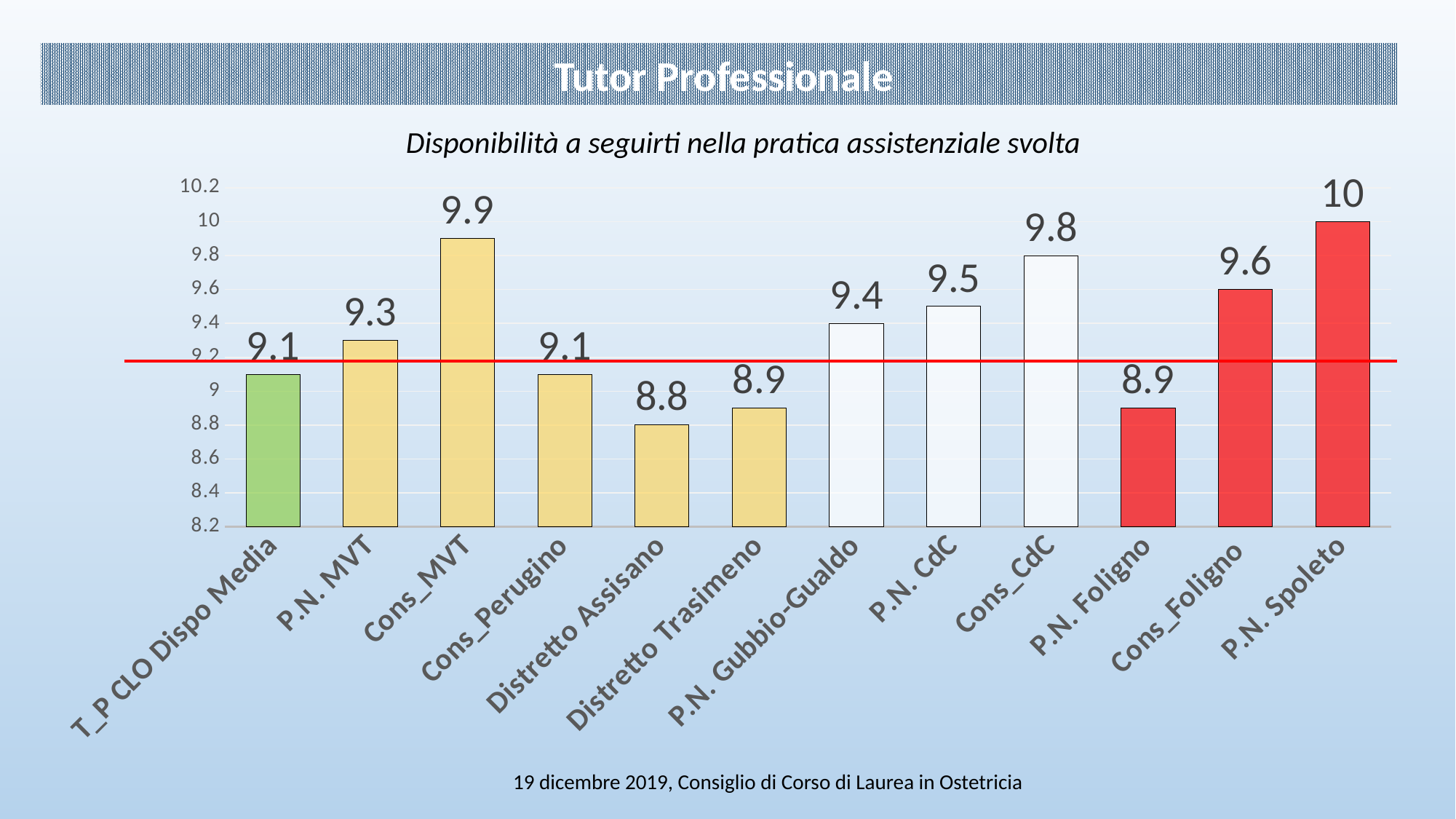
What is the value for P.N. Gubbio-Gualdo? 9.4 What is the difference between the values for P.N. Spoleto and Distretto Assisano? 1.2 What is the value for Distretto Assisano? 8.8 What is the value for Cons_Foligno? 9.6 Which category has the lowest value? Distretto Assisano What is the title of the chart? Disponibilità a seguirti nella pratica assistenziale svolta Which category has the highest value? P.N. Spoleto What is the value for Cons_MVT? 9.9 What is the difference between the values for Cons_CdC and P.N. CdC? 0.3 Which is larger, the value for P.N. MVT or the value for Cons_Perugino? P.N. MVT What kind of chart is shown on the slide? Bar chart How many categories are shown on the x axis? 12